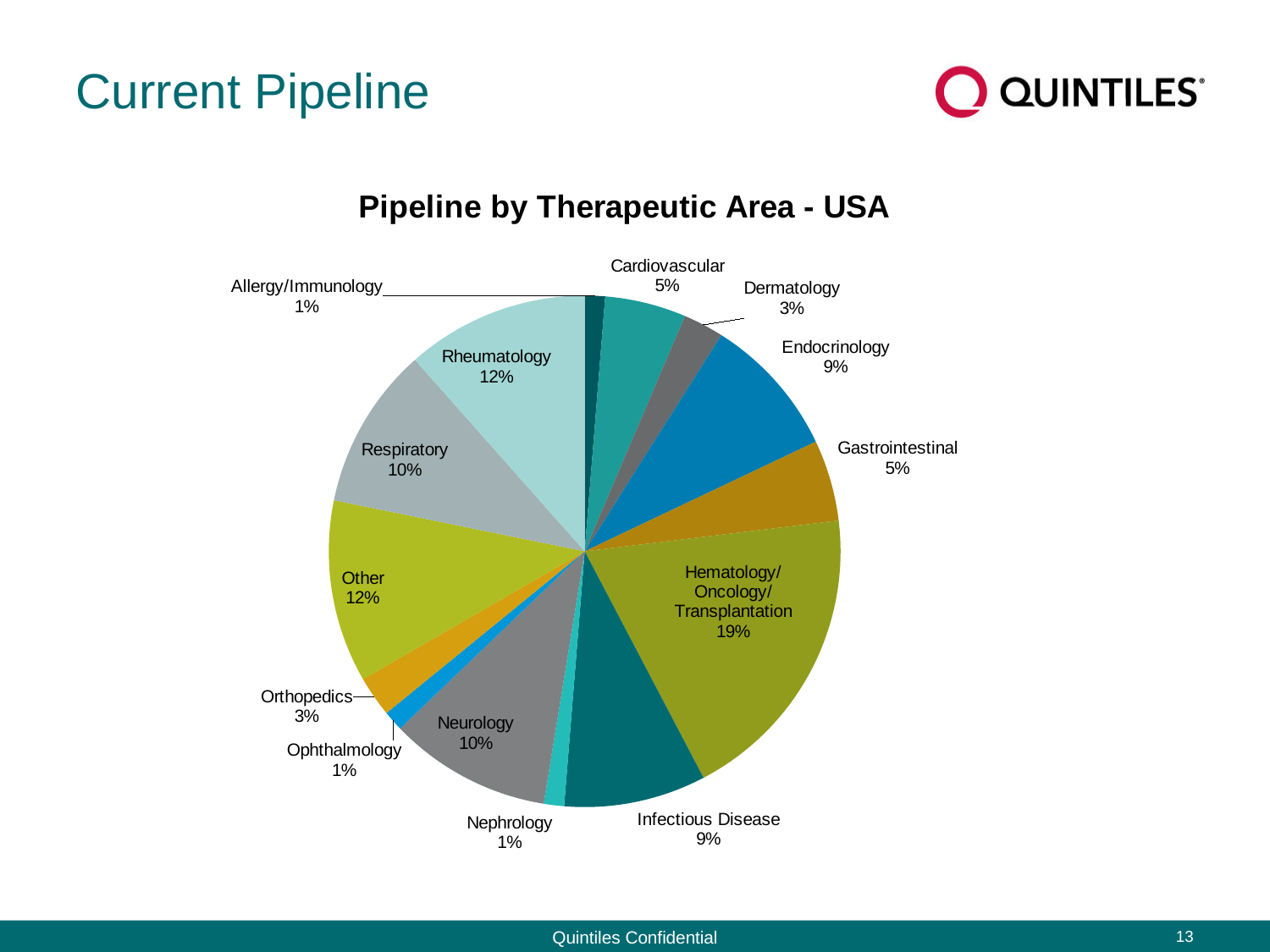
What is the combined share of Other and Rheumatology? 24% What type of chart is shown on the slide? pie chart Which is larger, the share for Neurology or the share for Dermatology? Neurology What percentage is shown for Nephrology? 1% What share of the pipeline is Hematology/Oncology/Transplantation? 19% What is the difference in percentage points between Rheumatology and Cardiovascular? 7 Which therapeutic area has the largest share of the pipeline? Hematology/Oncology/Transplantation How many therapeutic area slices does the pie chart have? 14 What percentage is shown for Orthopedics? 3% What percentage is shown for Respiratory? 10% What percentage is shown for Endocrinology? 9% What is the title of the chart? Pipeline by Therapeutic Area - USA